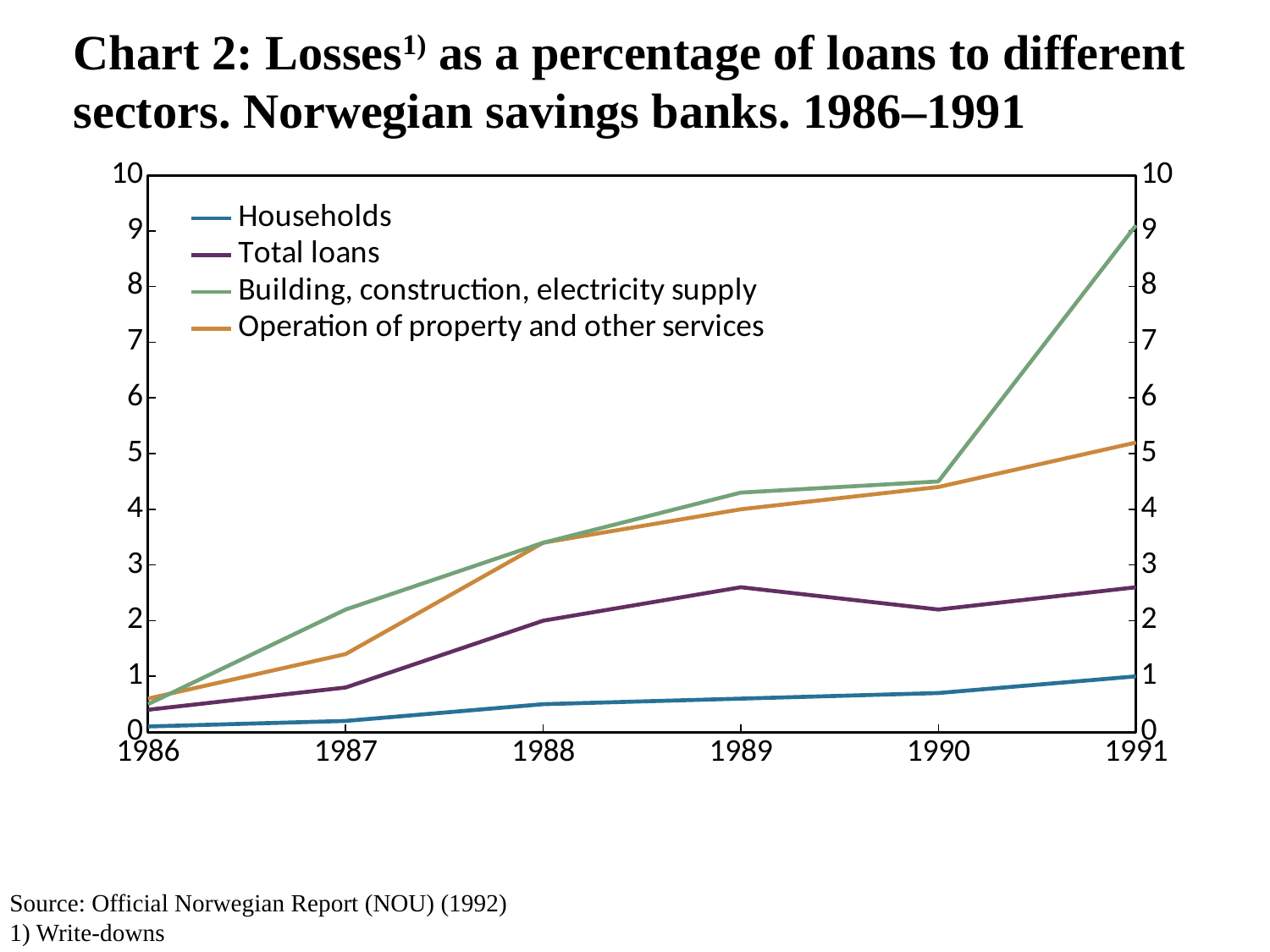
Is the value for Total loans in 1989 greater or less than 3? less Is the value for Operation of property and other services in 1991 greater or less than 5? greater In 1989, which is larger: Total loans or Households? Total loans How many series does the legend list? 4 Which series is drawn in green in the legend? Building, construction, electricity supply Which series has the highest value in 1991? Building, construction, electricity supply Which series has the lowest value in 1991? Households Is the value for Building, construction, electricity supply in 1991 greater or less than 8? greater Do the values for Households rise or fall from 1986 to 1991? rise What kind of chart is shown on the slide? line chart How many years are shown along the x axis? 6